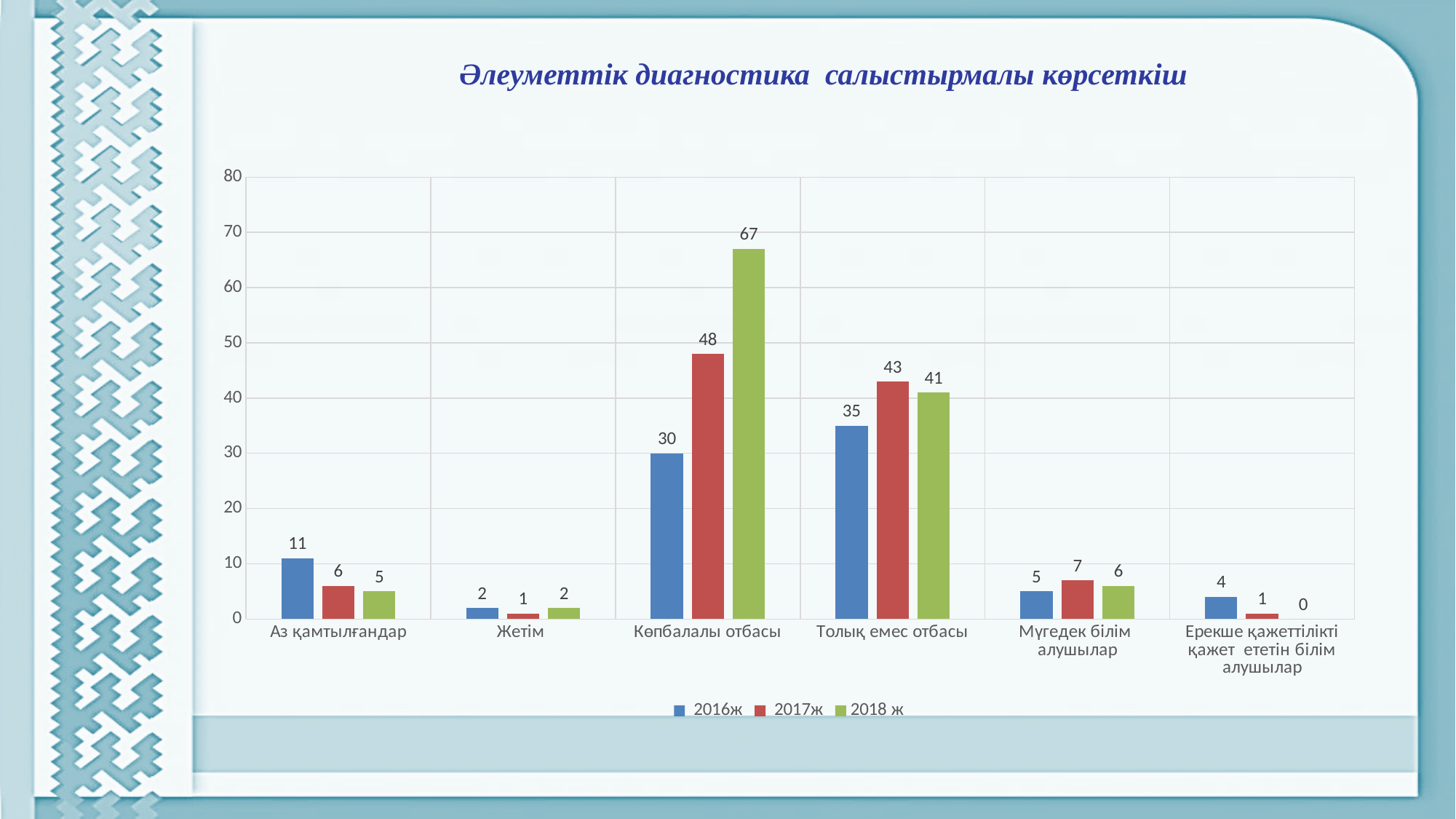
Which is larger for Толық емес отбасы: the 2017ж value or the 2018 ж value? 2017ж How many series does the legend list? 3 What is the title of the chart? Әлеуметтік диагностика салыстырмалы көрсеткіш How many categories are shown on the x axis? 6 What is the value for Аз қамтылғандар in the 2017ж series? 6 Is the 2017ж value for Көпбалалы отбасы greater or less than 40? greater Which category has the highest value in the 2018 ж series? Көпбалалы отбасы What is the value for Толық емес отбасы in the 2016ж series? 35 What is the difference between the 2018 ж and 2016ж values for Көпбалалы отбасы? 37 Which category has the lowest value in the 2016ж series? Жетім What is the value for Көпбалалы отбасы in the 2018 ж series? 67 What kind of chart is shown on the slide? bar chart